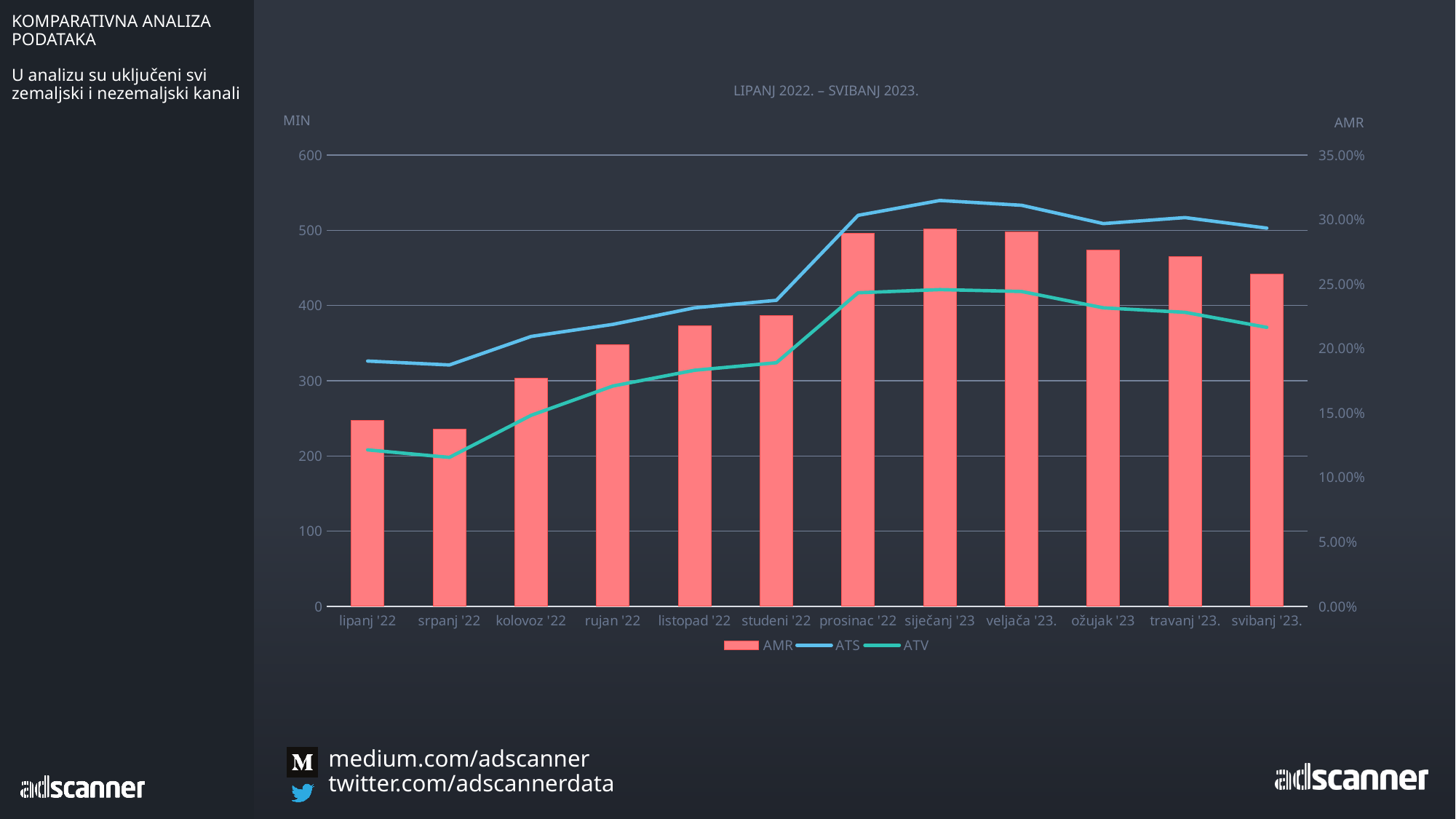
Is the AMR bar for lipanj '22 greater or less than 300? less Do the AMR bars generally rise or fall from lipanj '22 to siječanj '23? rise What kind of chart is shown on the slide? A combined bar and line chart Which has the larger AMR bar, kolovoz '22 or rujan '22? rujan '22 How many months are shown along the x axis of the chart? 12 How many series does the chart legend list? 3 Which series is plotted as bars in the chart? AMR Which has the larger AMR bar, ožujak '23 or svibanj '23? ožujak '23 What is the title of the chart? LIPANJ 2022. – SVIBANJ 2023. Which month has the lowest AMR bar? srpanj '22